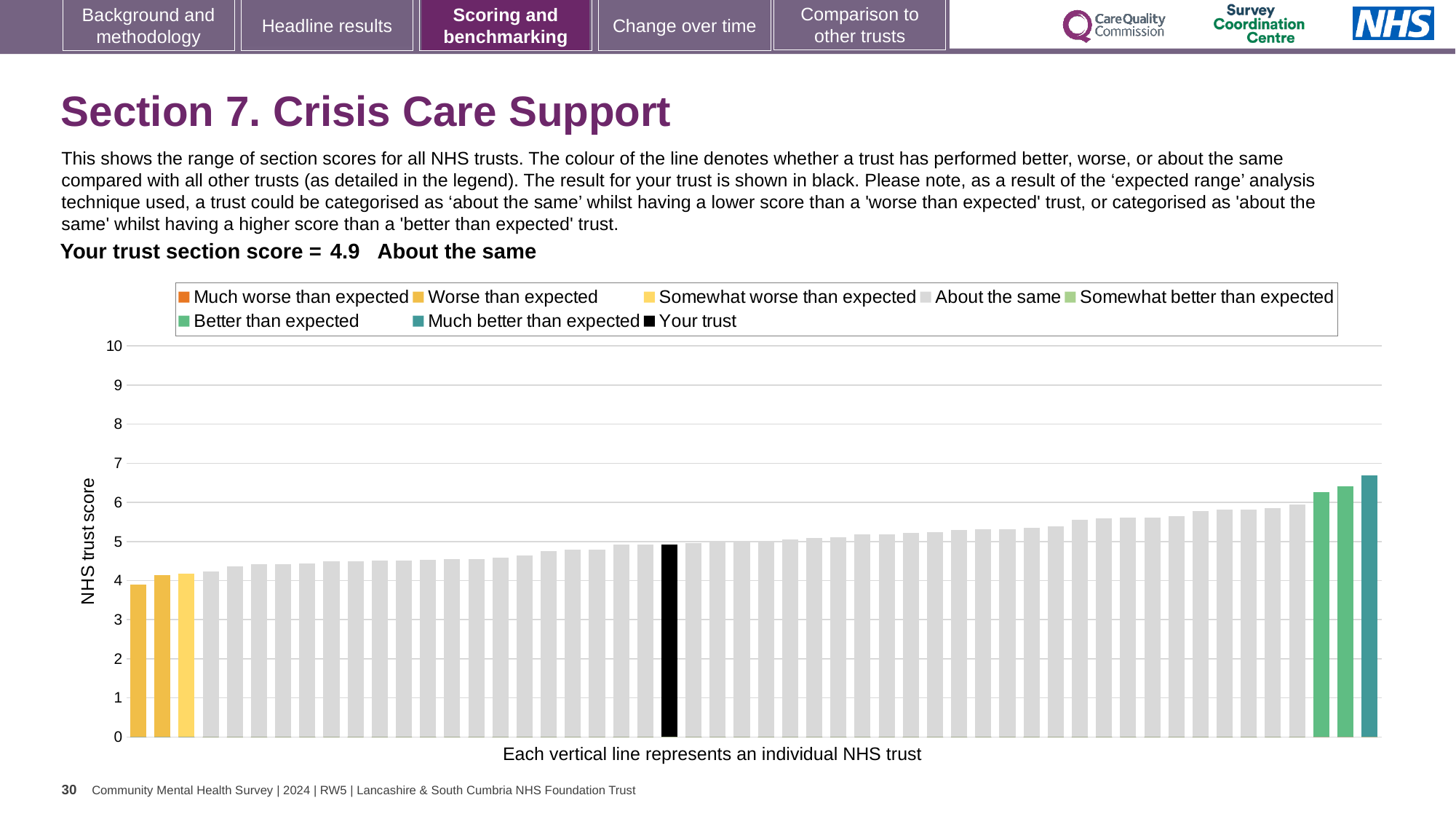
Is the black 'Your trust' bar higher or lower than the tallest teal bar? lower Is the value of the tallest bar greater or less than 7? less What is the section score for your trust shown on the slide? 4.9 How many entries does the chart legend list? 8 Is the value of the shortest bar greater or less than 5? less Which legend category does the tallest bar in the chart belong to? Much better than expected Is the value of the black 'Your trust' bar greater or less than 6? less Which legend category does the shortest bar in the chart belong to? Worse than expected What kind of chart is shown on the slide? bar chart Do the bar values rise or fall from left to right across the chart? rise What is the label on the vertical axis of the chart? NHS trust score